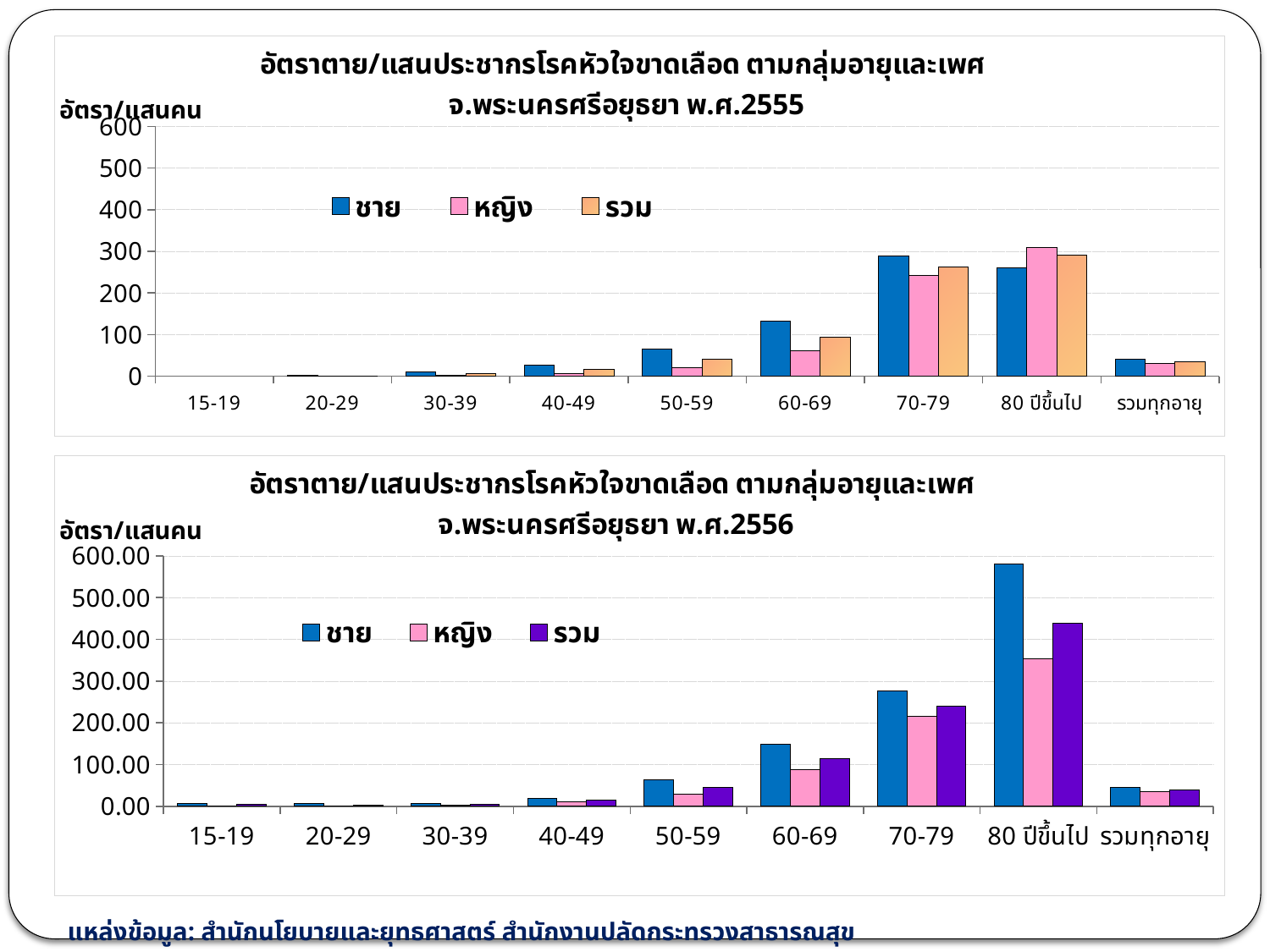
In the top chart (พ.ศ.2555), for the 80 ปีขึ้นไป group, which is larger: ชาย or หญิง? หญิง In the bottom chart (พ.ศ.2556), what colour represents the รวม series? purple In the bottom chart (พ.ศ.2556), is the value for ชาย in the 80 ปีขึ้นไป group greater or less than 500.00? greater In the bottom chart (พ.ศ.2556), for the 80 ปีขึ้นไป group, which is larger: ชาย or หญิง? ชาย In the top chart (พ.ศ.2555), how many series does the legend list? 3 In the bottom chart (พ.ศ.2556), how many age-group categories are shown on the x axis? 9 In the top chart (พ.ศ.2555), is the value for ชาย in the 70-79 group greater or less than 200? greater In the top chart (พ.ศ.2555), is the value for หญิง in the 60-69 group greater or less than 100? less In the top chart (พ.ศ.2555), which age group has the highest value for หญิง? 80 ปีขึ้นไป In the bottom chart (พ.ศ.2556), which age group has the highest value for ชาย? 80 ปีขึ้นไป In the top chart (พ.ศ.2555), what kind of chart is shown? bar chart In the top chart (พ.ศ.2555), which age group has the highest value for ชาย? 70-79